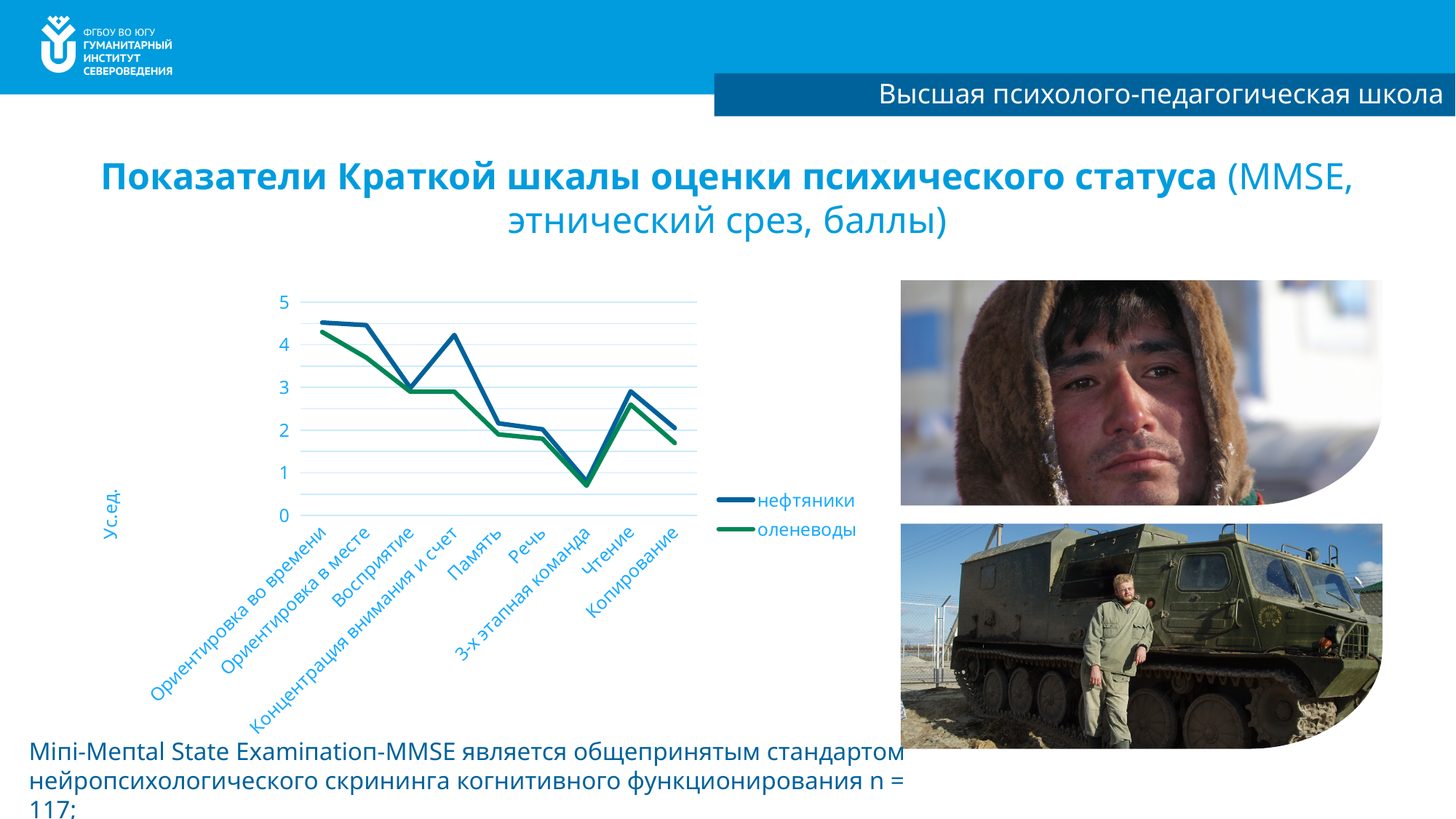
Is the value for нефтяники at Ориентировка во времени greater or less than 4? greater Do the values for нефтяники rise or fall from Ориентировка в месте to Восприятие? fall Is the value for оленеводы at 3-х этапная команда greater or less than 1? less How many categories are plotted along the x axis of the chart? 9 For which category is the value for оленеводы highest? Ориентировка во времени What is the label on the vertical axis of the chart? Ус.ед. At Концентрация внимания и счет, which series has the larger value, нефтяники or оленеводы? нефтяники What kind of chart is shown on the slide? line chart For which category is the value for нефтяники lowest? 3-х этапная команда For which category is the value for оленеводы lowest? 3-х этапная команда How many series does the chart legend list? 2 Which series is drawn in green in the chart? оленеводы